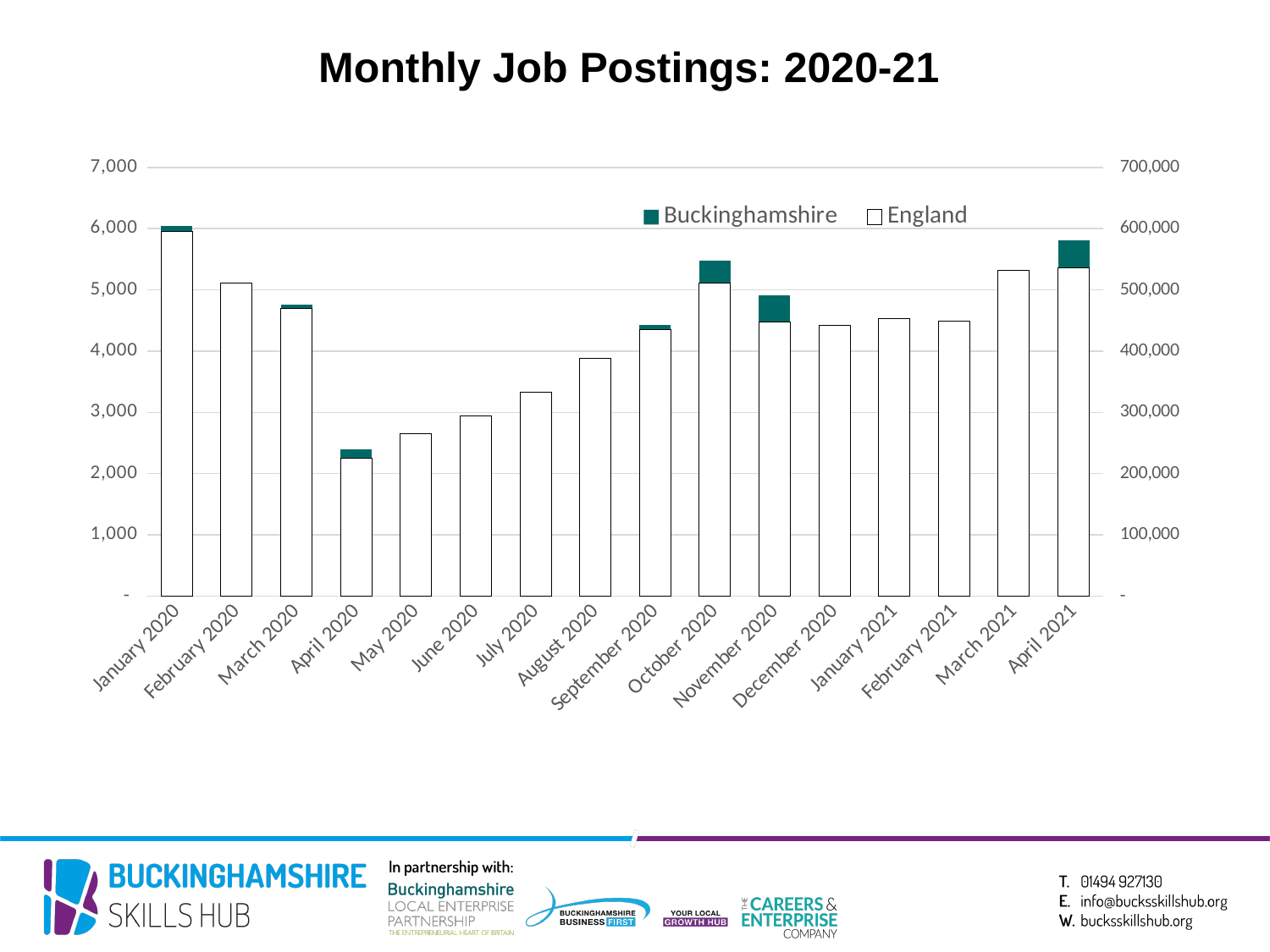
Do the England values rise or fall from April 2020 to October 2020? rise What kind of chart is shown on the slide? bar chart How many months are shown along the x axis? 16 Is the England value for January 2020 greater or less than 500,000 on the right-hand axis? greater Do the England values rise or fall from January 2020 to April 2020? fall How many series does the legend list? 2 Which month has the larger England value, February 2020 or May 2020? February 2020 In which month is the England value highest? January 2020 Is the England value for April 2020 greater or less than 300,000 on the right-hand axis? less What is the title of the chart? Monthly Job Postings: 2020-21 In which month is the England value lowest? April 2020 Which two series are listed in the legend? Buckinghamshire and England